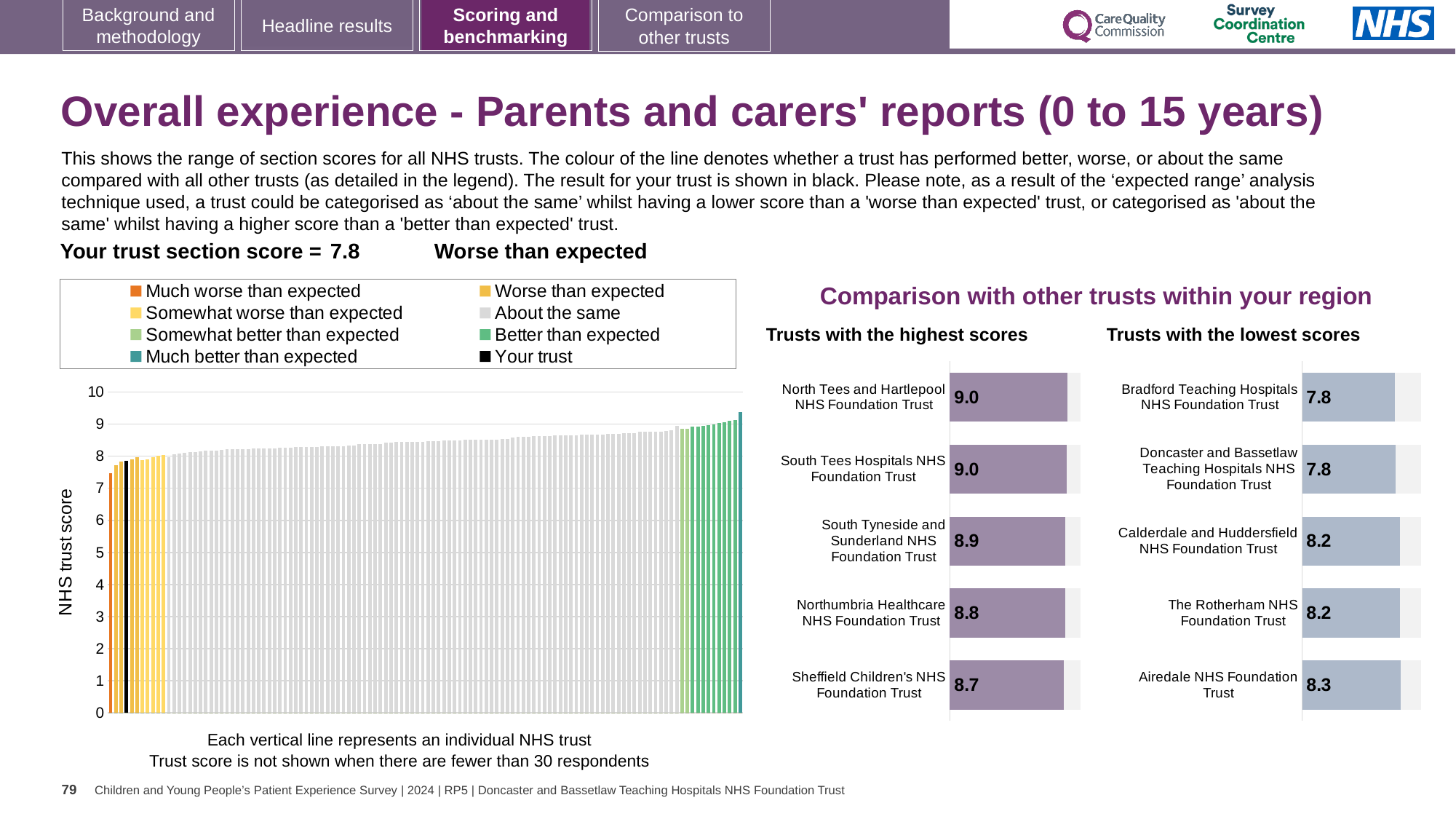
In the 'Trusts with the lowest scores' chart, which trust has the highest score? Airedale NHS Foundation Trust In the 'Trusts with the highest scores' chart, which trust has the lowest score? Sheffield Children's NHS Foundation Trust How many trusts are listed in the 'Trusts with the lowest scores' chart? 5 How many entries does the legend of the main chart on the left list? 8 In the 'Trusts with the highest scores' chart, what is the difference between the scores of North Tees and Hartlepool NHS Foundation Trust and Sheffield Children's NHS Foundation Trust? 0.3 In the 'Trusts with the lowest scores' chart, what is the score for Calderdale and Huddersfield NHS Foundation Trust? 8.2 In the 'Trusts with the lowest scores' chart, which has the higher score: Calderdale and Huddersfield NHS Foundation Trust or Bradford Teaching Hospitals NHS Foundation Trust? Calderdale and Huddersfield NHS Foundation Trust In the 'Trusts with the highest scores' chart, what is the score for Sheffield Children's NHS Foundation Trust? 8.7 What kind of chart is the main chart on the left showing all NHS trusts? Bar chart In the 'Trusts with the highest scores' chart, what is the score for North Tees and Hartlepool NHS Foundation Trust? 9.0 In the 'Trusts with the lowest scores' chart, what is the difference between the scores of Airedale NHS Foundation Trust and Bradford Teaching Hospitals NHS Foundation Trust? 0.5 In the main chart on the left showing all NHS trusts, is the value of the tallest bar greater or less than 9? greater